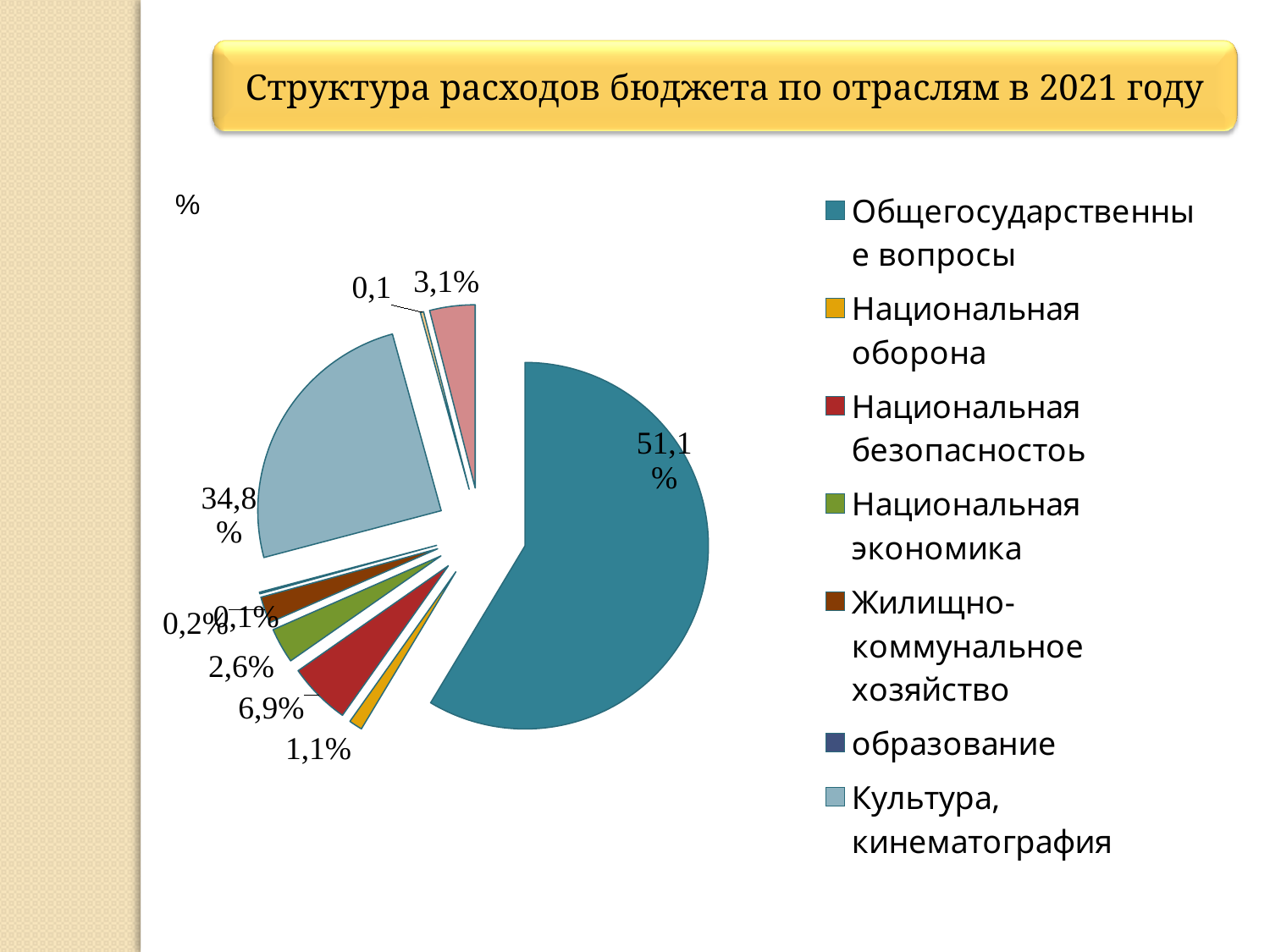
How many entries does the legend list? 7 What is the title of the chart on the slide? Структура расходов бюджета по отраслям в 2021 году What is the difference between the shares of Общегосударственные вопросы and Культура, кинематография? 16,3% What share of the pie does Национальная экономика take? 2,6% Which category has the largest share of the pie? Общегосударственные вопросы What share of the pie does Культура, кинематография take? 34,8% What share of the pie does Национальная безопасность take? 6,9% What kind of chart is shown on the slide? pie chart Which is larger: the share for Национальная безопасность or for Национальная экономика? Национальная безопасность What share of the pie does Национальная оборона take? 1,1% What share of the pie does Общегосударственные вопросы take? 51,1% What is the difference between the shares of Национальная безопасность and Национальная оборона? 5,8%